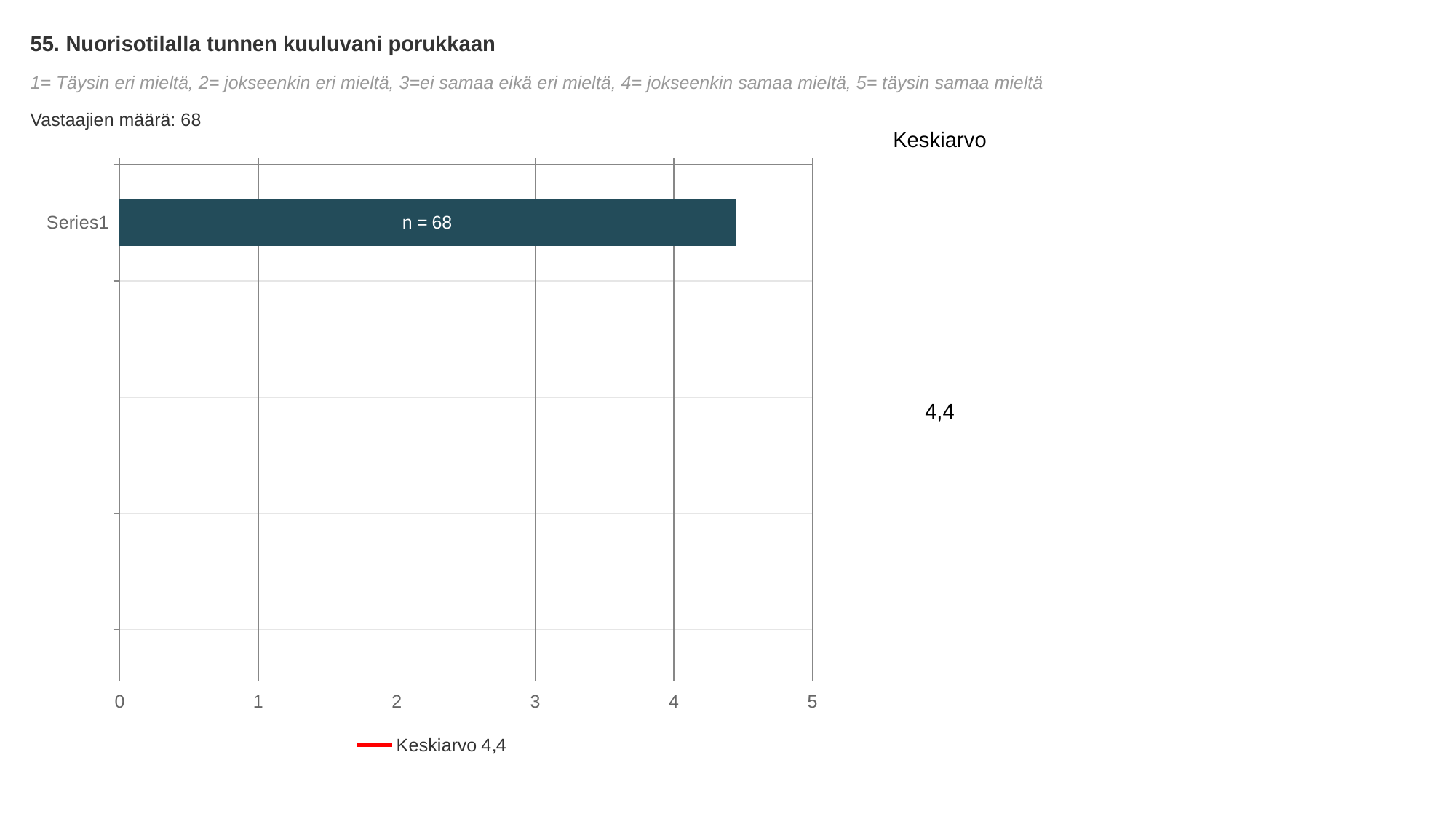
Is the value of the Series1 bar greater or less than 3? greater How many bars are plotted in the chart? 1 What text does the legend entry show? Keskiarvo 4,4 Is the value of the Series1 bar greater or less than 5? less What label is printed inside the Series1 bar? n = 68 What is the maximum value shown on the x axis? 5 How many entries does the chart legend list? 1 What is the number of respondents (Vastaajien määrä) stated on the slide? 68 What kind of chart is shown on the slide? bar chart What is the title of the chart on the slide? 55. Nuorisotilalla tunnen kuuluvani porukkaan Is the value of the Series1 bar greater or less than 4? greater What is the Keskiarvo (mean) value shown on the slide? 4,4